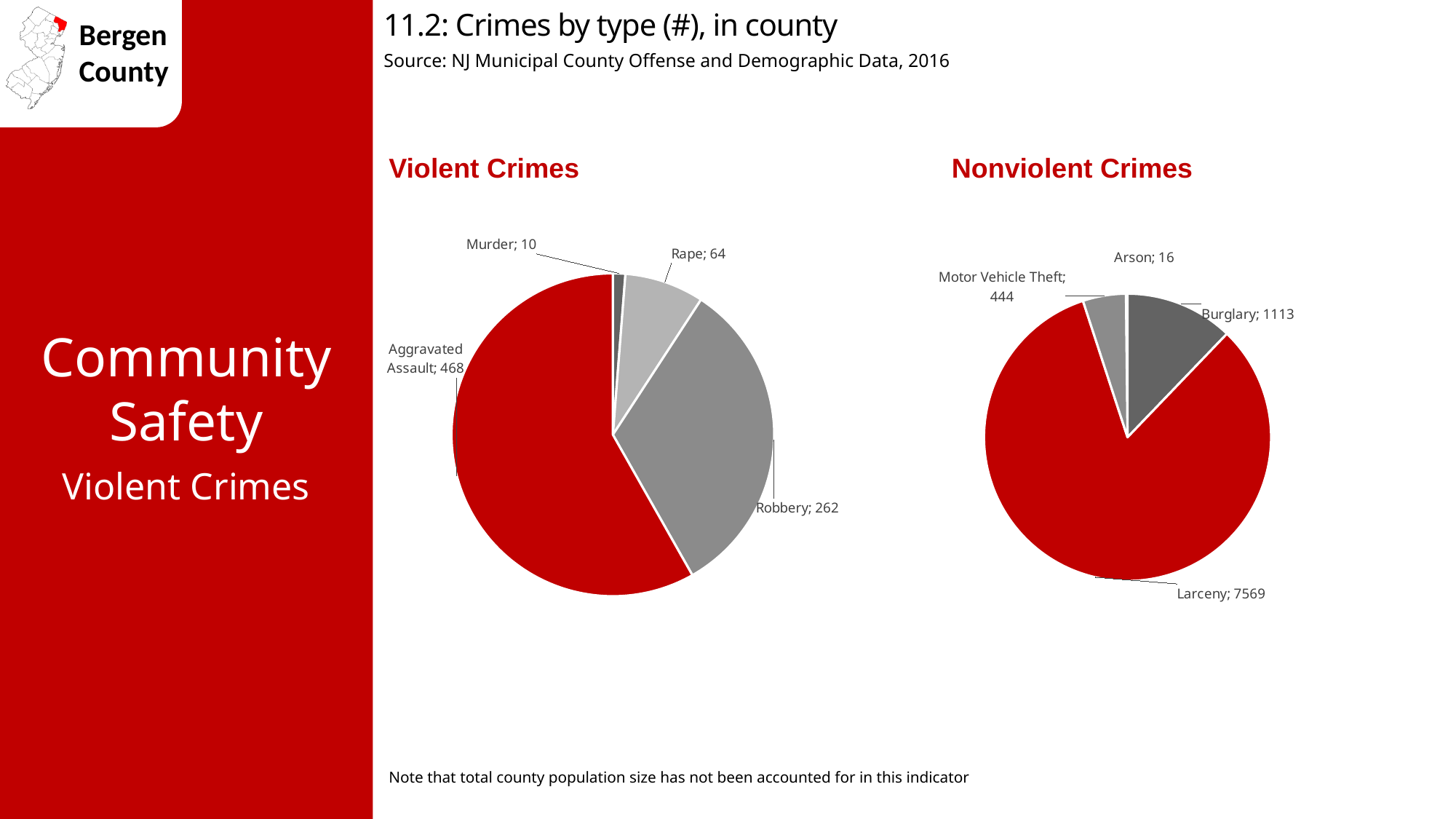
In the Nonviolent Crimes chart, what is the value for Motor Vehicle Theft? 444 How many crime types are shown in the Nonviolent Crimes chart? 4 In the Nonviolent Crimes chart, what is the difference between Larceny and Burglary? 6456 In the Nonviolent Crimes chart, which crime type has the smallest slice? Arson What kind of chart is used for Violent Crimes? Pie chart What is the total number of nonviolent crimes across all slices in the Nonviolent Crimes chart? 9142 In the Violent Crimes chart, which is larger, Rape or Murder? Rape What is the total number of violent crimes across all slices in the Violent Crimes chart? 804 In the Violent Crimes chart, what is the difference between Aggravated Assault and Robbery? 206 What is the source cited for the data on this slide? NJ Municipal County Offense and Demographic Data, 2016 In the Violent Crimes chart, which crime type has the largest slice? Aggravated Assault In the Violent Crimes chart, how many robberies are shown? 262